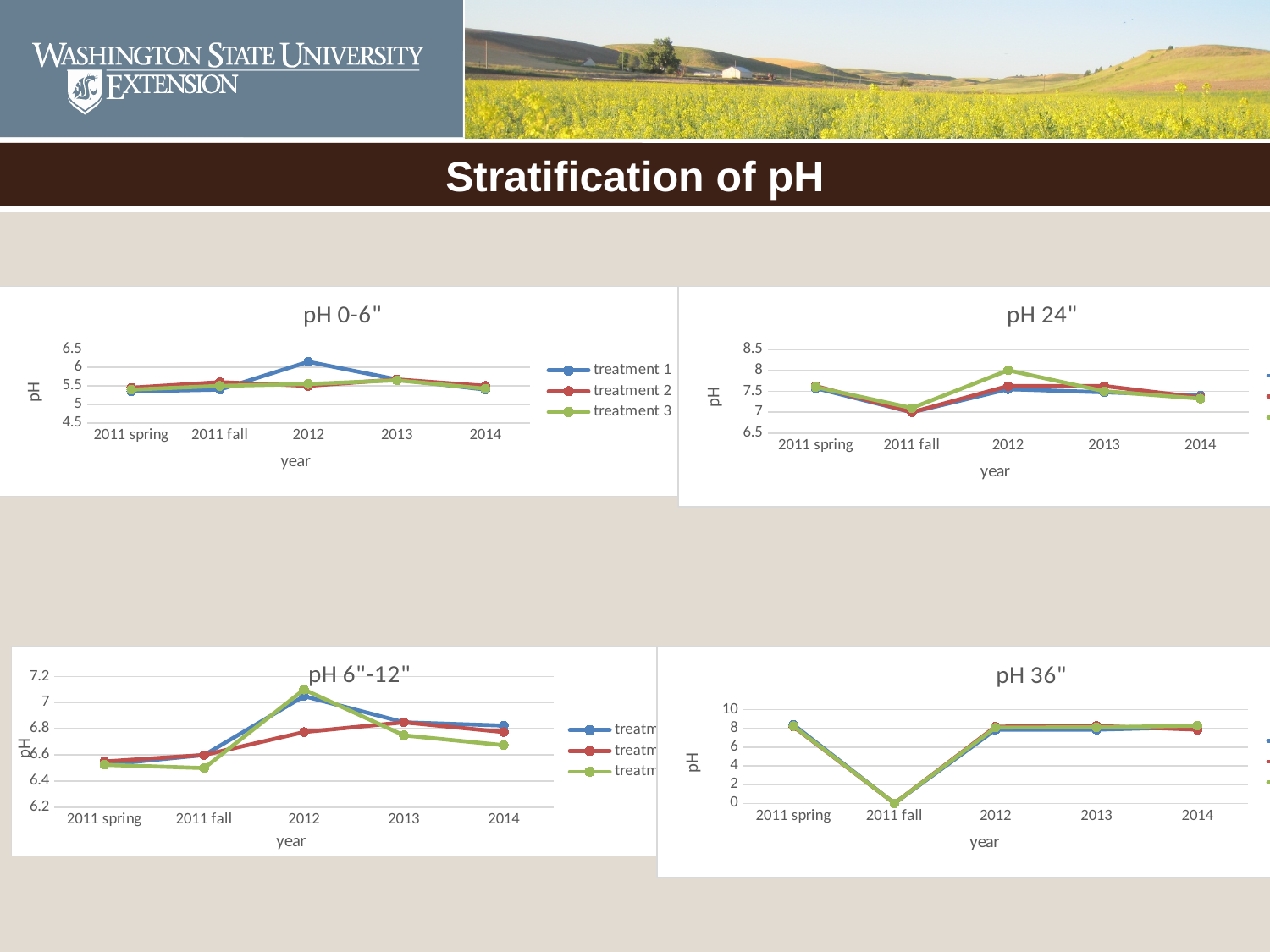
In the "pH 36"" chart, in which year do the series drop to their lowest value? 2011 fall In the "pH 24"" chart, in which year do all three series reach their lowest value? 2011 fall What is the x-axis title of the "pH 24"" chart? year What kind of chart is the "pH 0-6"" chart? line chart In the "pH 0-6"" chart, how many points are plotted along the x axis for each series? 5 In the "pH 6"-12"" chart, is the highest value in 2012 greater or less than 6.8? greater How many charts are shown on the slide? 4 In the "pH 0-6"" chart, which is larger in 2012: treatment 1 or treatment 2? treatment 1 In the "pH 0-6"" chart, is the value for treatment 1 in 2012 greater or less than 5.5? greater In the "pH 0-6"" chart, in which year does treatment 1 reach its highest value? 2012 In the "pH 0-6"" chart, how many series does the legend list? 3 In the "pH 24"" chart, is the highest value in 2012 greater or less than 7.5? greater